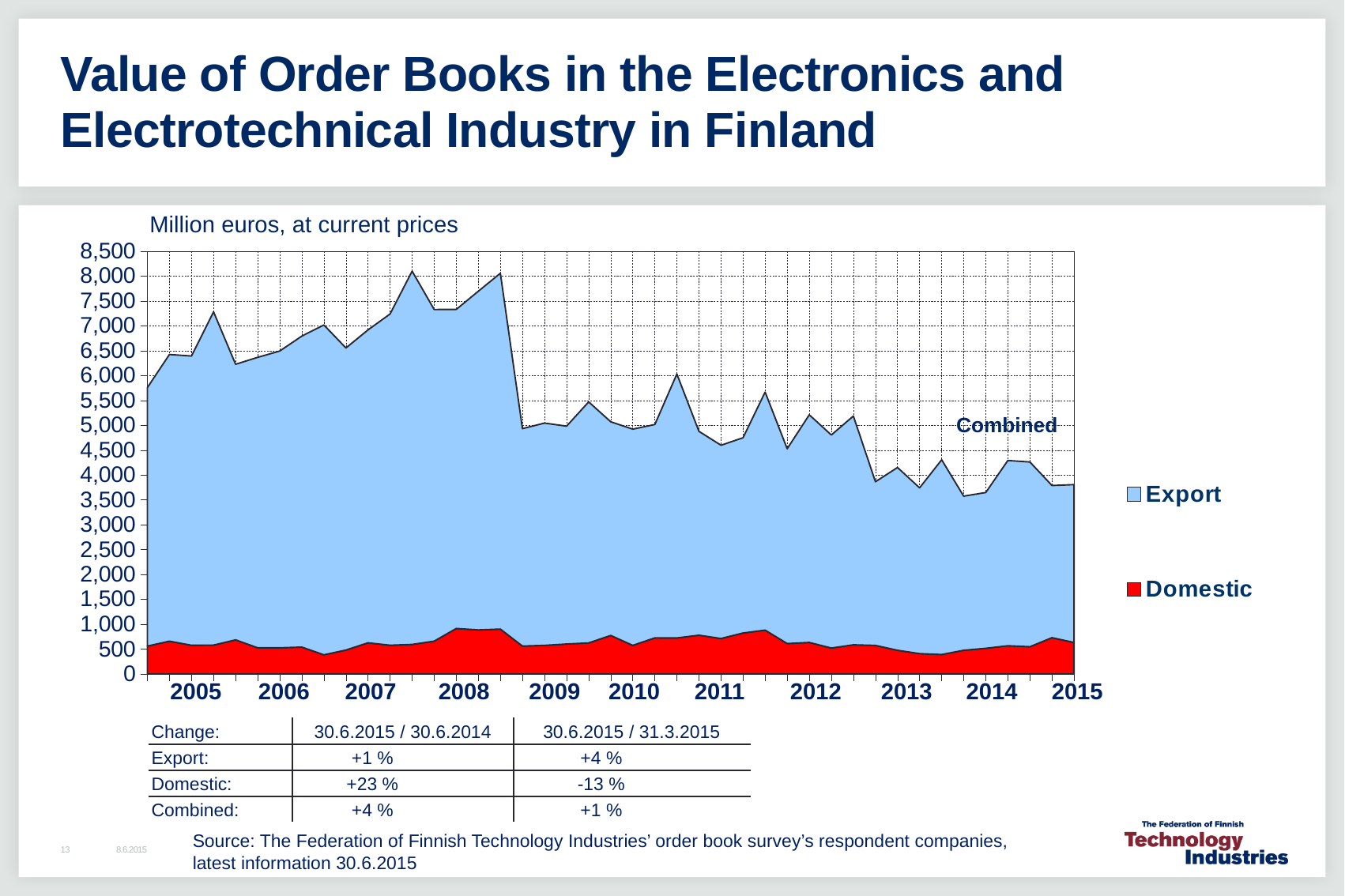
Is the combined value at the start of 2005 greater or less than 5,500? greater Is the combined value at the end of the series in 2015 greater or less than 4,000? less How many series does the legend list? 2 Is the Domestic value ever greater than 1,000 at any point on the chart? No Is the combined value higher at the start of 2005 or at the end of 2015? 2005 Do the combined values generally rise or fall from 2008 to 2015? Fall What are the two series named in the legend? Export and Domestic In what units are the values on the chart expressed? Million euros, at current prices How many years are labelled on the x axis? 11 Which series is larger throughout the chart, Export or Domestic? Export According to the change table, what is the Domestic change for 30.6.2015 / 30.6.2014? +23 % What kind of chart is shown on the slide? Area chart